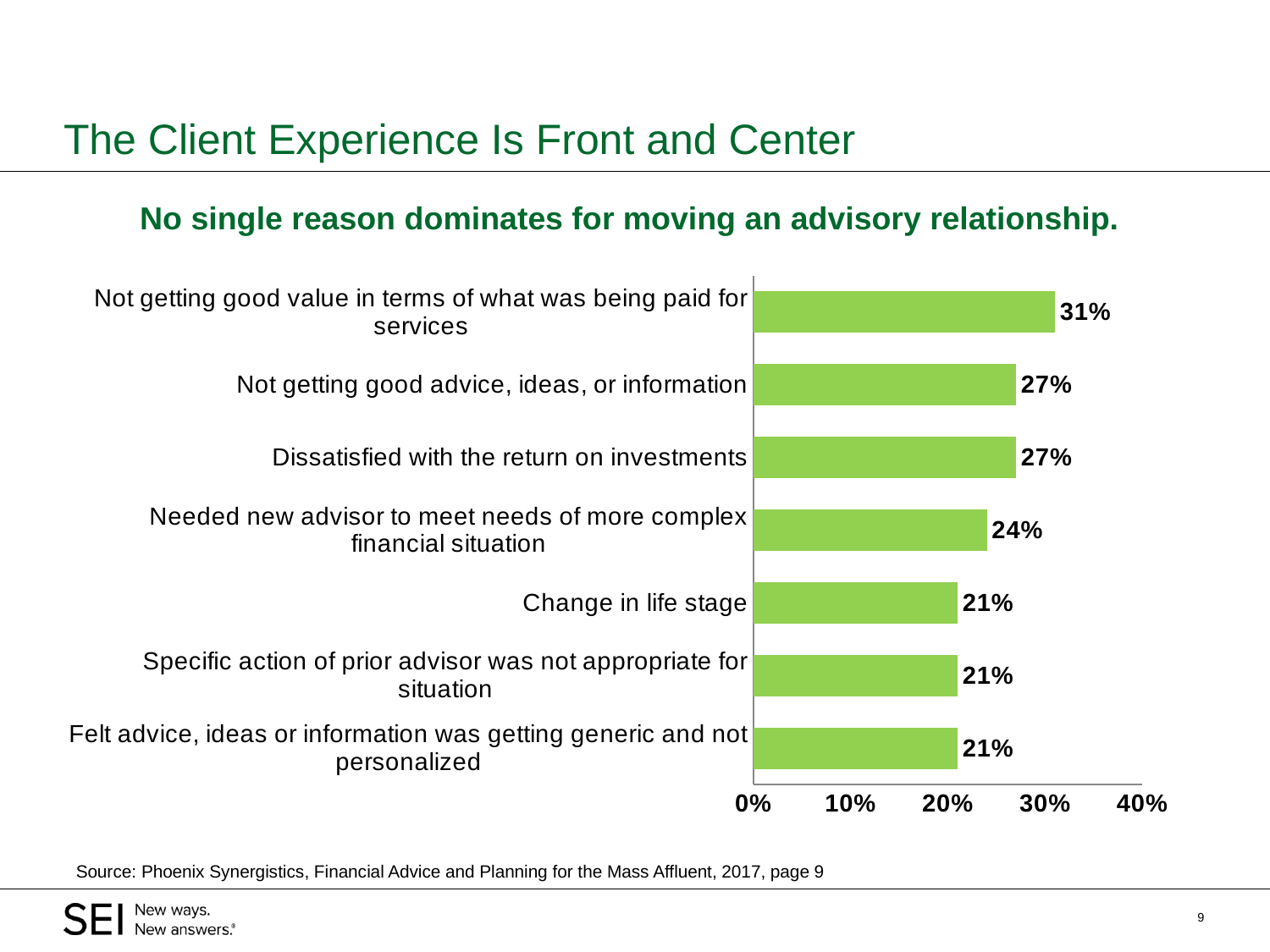
What is the difference between "Not getting good advice, ideas, or information" and "Needed new advisor to meet needs of more complex financial situation"? 3% What percentage is shown for "Needed new advisor to meet needs of more complex financial situation"? 24% How many reasons share the value 21%? 3 What is the value for "Not getting good value in terms of what was being paid for services"? 31% What percentage is shown for "Change in life stage"? 21% What kind of chart is shown on the slide? Bar chart What is the difference between the value for "Not getting good value in terms of what was being paid for services" and the value for "Change in life stage"? 10% Which is larger: the value for "Dissatisfied with the return on investments" or the value for "Change in life stage"? Dissatisfied with the return on investments What is the highest value shown on the horizontal axis? 40% Is the value for "Not getting good value in terms of what was being paid for services" greater or less than 30%? greater Which reason has the highest percentage? Not getting good value in terms of what was being paid for services How many reasons are plotted in the chart? 7